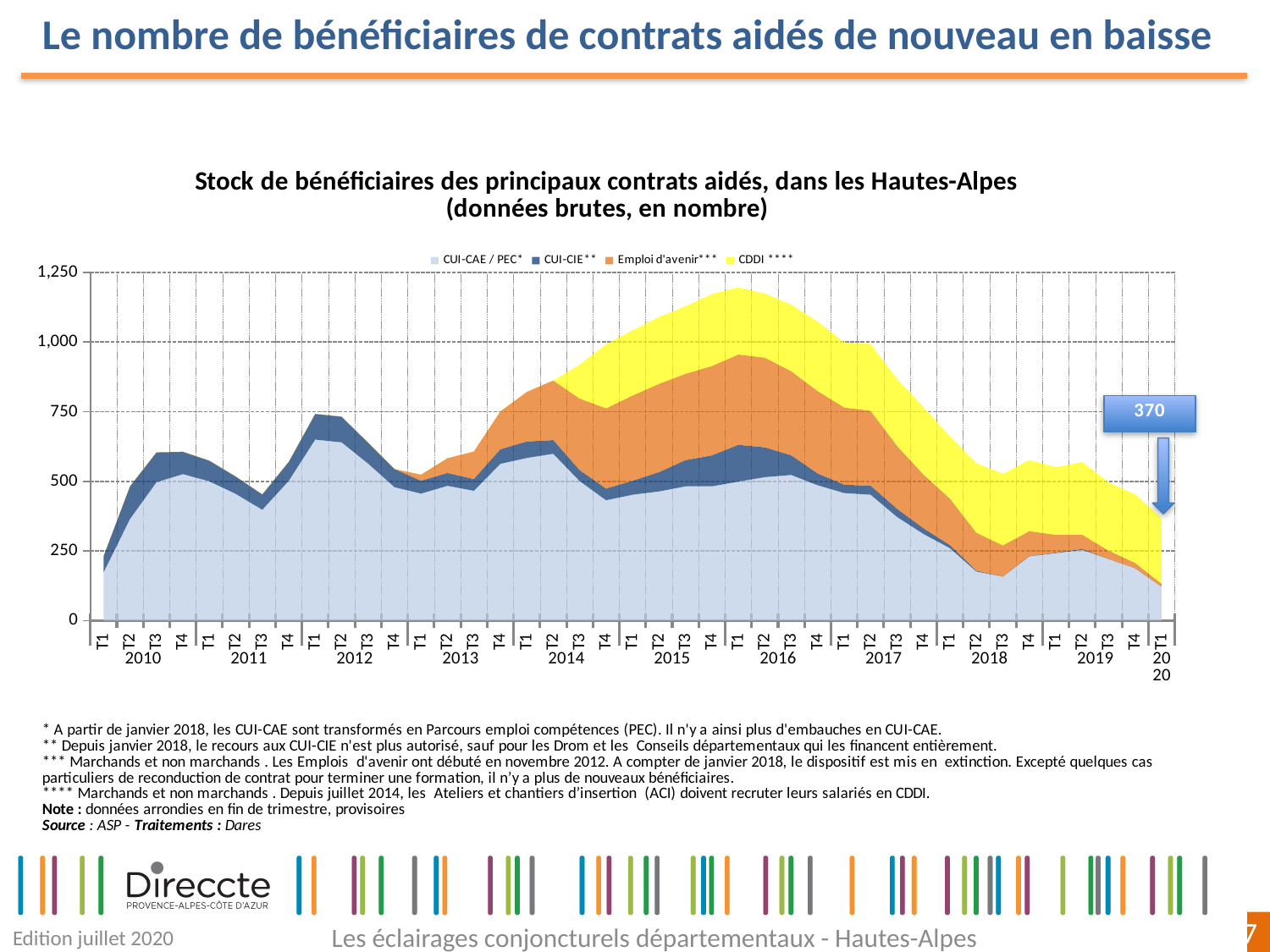
How many year labels appear along the x axis? 11 Is the total stock of beneficiaries at T1 2016 greater or less than 1,000? greater In which year does the stacked total reach its highest point? 2016 Which series is shown in yellow? CDDI **** What kind of chart is shown on the slide? Stacked area chart What is the title of the chart? Stock de bénéficiaires des principaux contrats aidés, dans les Hautes-Alpes (données brutes, en nombre) Is the total stock of beneficiaries at T1 2012 greater or less than 500? greater What is the total stock of beneficiaries shown by the data label for T1 2020? 370 How many series does the legend list? 4 Is the total stock of beneficiaries at T1 2018 greater or less than 750? less Does the total stock of beneficiaries rise or fall between T1 2016 and T1 2020? fall